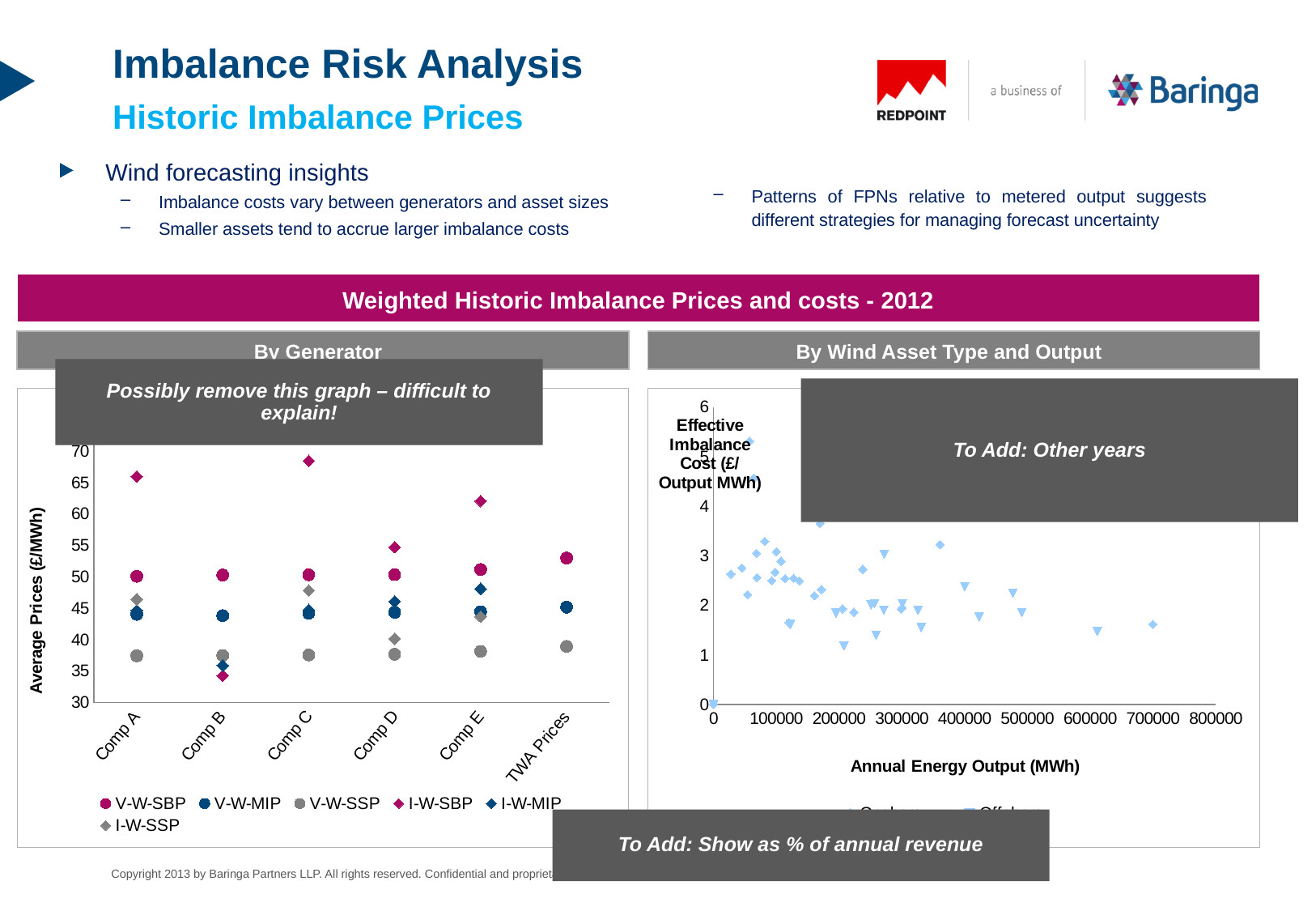
In the 'By Generator' chart, is the I-W-SBP value for Comp B greater or less than 40? less What is the x-axis label of the 'By Wind Asset Type and Output' chart? Annual Energy Output (MWh) What kind of chart is the 'By Generator' chart? Scatter chart In the 'By Generator' chart, which category has the highest I-W-SBP value? Comp C What is the y-axis label of the 'By Generator' chart? Average Prices (£/MWh) In the 'By Generator' chart, how many series does the legend list? 6 In the 'By Generator' chart, how many categories are shown on the x axis? 6 In the 'By Generator' chart, for Comp A, which is larger: the I-W-SBP value or the V-W-SBP value? I-W-SBP In the 'By Generator' chart, is the I-W-SBP value for Comp A greater or less than 60? greater In the 'By Generator' chart, is the V-W-SSP value for Comp A greater or less than 40? less In the 'By Generator' chart, for Comp B, which is larger: the V-W-SBP value or the I-W-SBP value? V-W-SBP In the 'By Generator' chart, which category has the lowest I-W-SBP value? Comp B